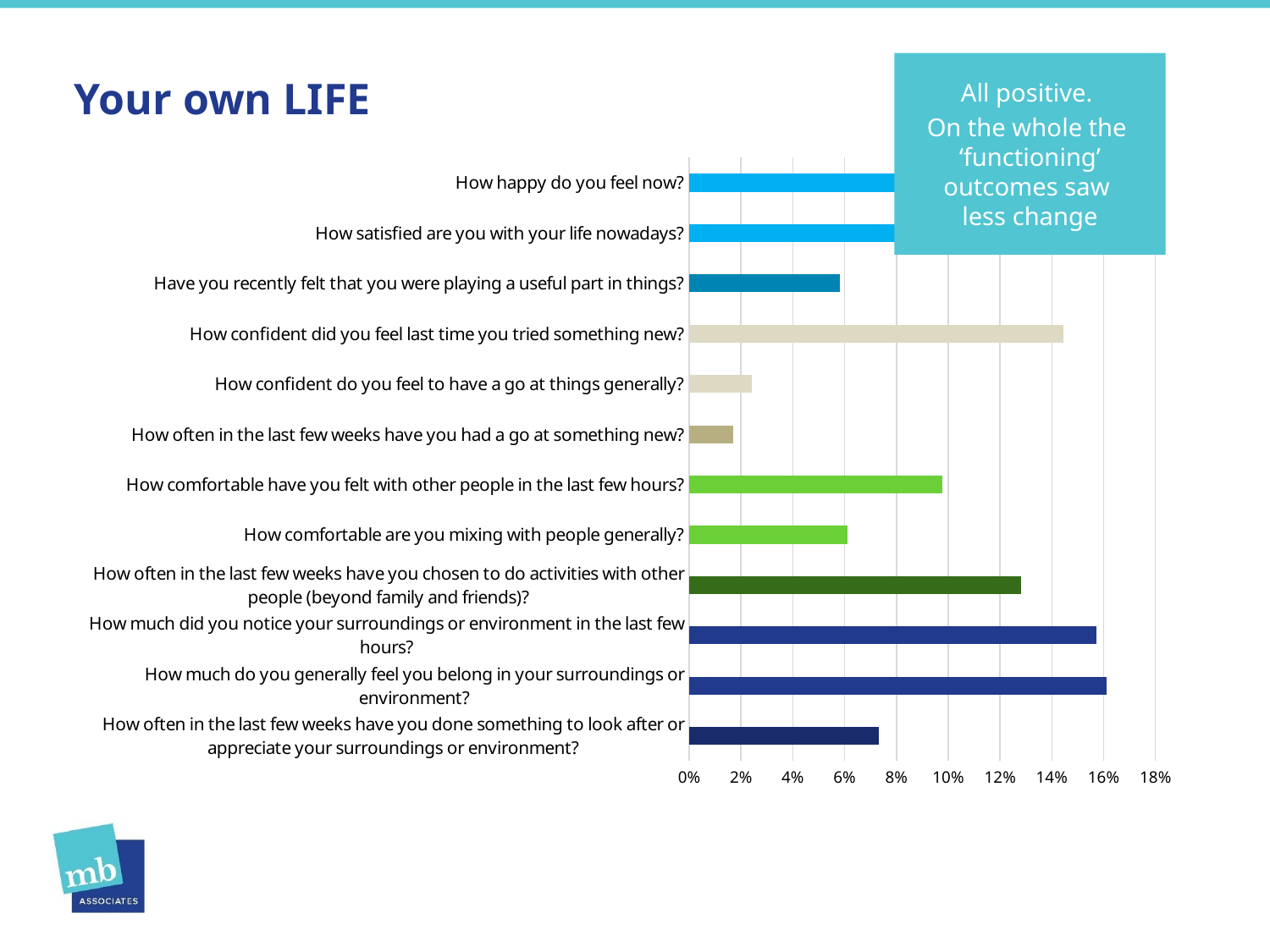
Is the value for "Have you recently felt that you were playing a useful part in things?" greater or less than 8%? less Which category has the lowest value in the chart? How often in the last few weeks have you had a go at something new? Is the value for "How confident did you feel last time you tried something new?" greater or less than 12%? greater Is the value for "How often in the last few weeks have you chosen to do activities with other people (beyond family and friends)?" greater or less than 10%? greater How many questions (categories) are plotted in the bar chart? 12 Which is larger: the value for "How comfortable have you felt with other people in the last few hours?" or "How comfortable are you mixing with people generally?" How comfortable have you felt with other people in the last few hours? What is the highest value shown on the chart's horizontal axis? 18% Which is larger: the value for "How confident did you feel last time you tried something new?" or "How confident do you feel to have a go at things generally?" How confident did you feel last time you tried something new? What kind of chart is shown on the slide? bar chart What is the title of the slide containing the chart? Your own LIFE